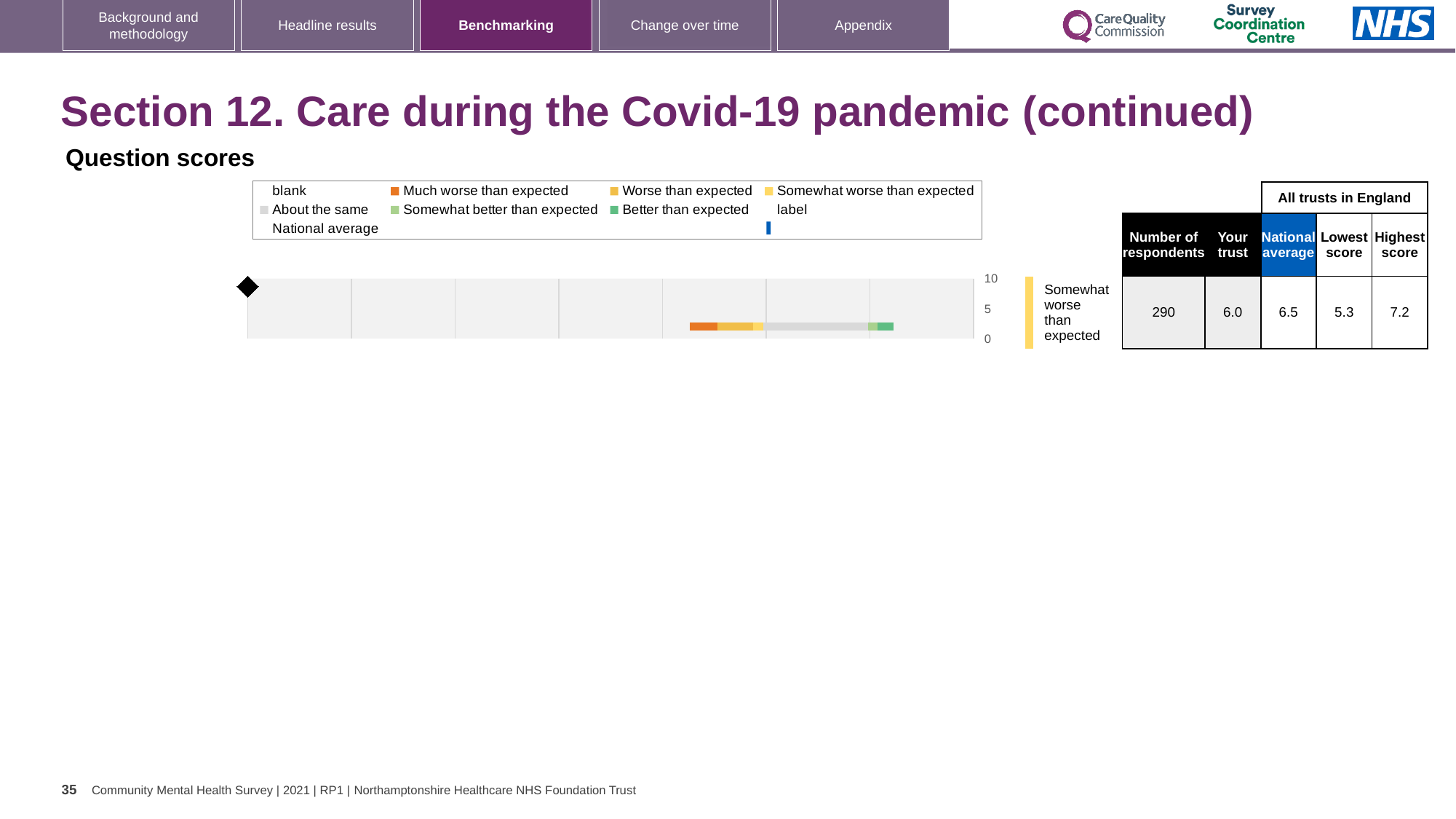
What is the National average score shown for this question? 6.5 What is the maximum value shown on the chart's score axis? 10 Which is larger, Your trust score or the National average? National average Is the Your trust score greater or less than 5? greater What kind of chart is used to show the question score? bar chart What is the difference between the National average and Your trust score? 0.5 What is the Lowest score among all trusts in England for this question? 5.3 What is the difference between the Highest score and the Lowest score for this question? 1.9 How many respondents answered this question? 290 Which benchmark category label is shown next to the chart for this question? Somewhat worse than expected What is the score for Your trust shown for this question? 6.0 What is the Highest score among all trusts in England for this question? 7.2